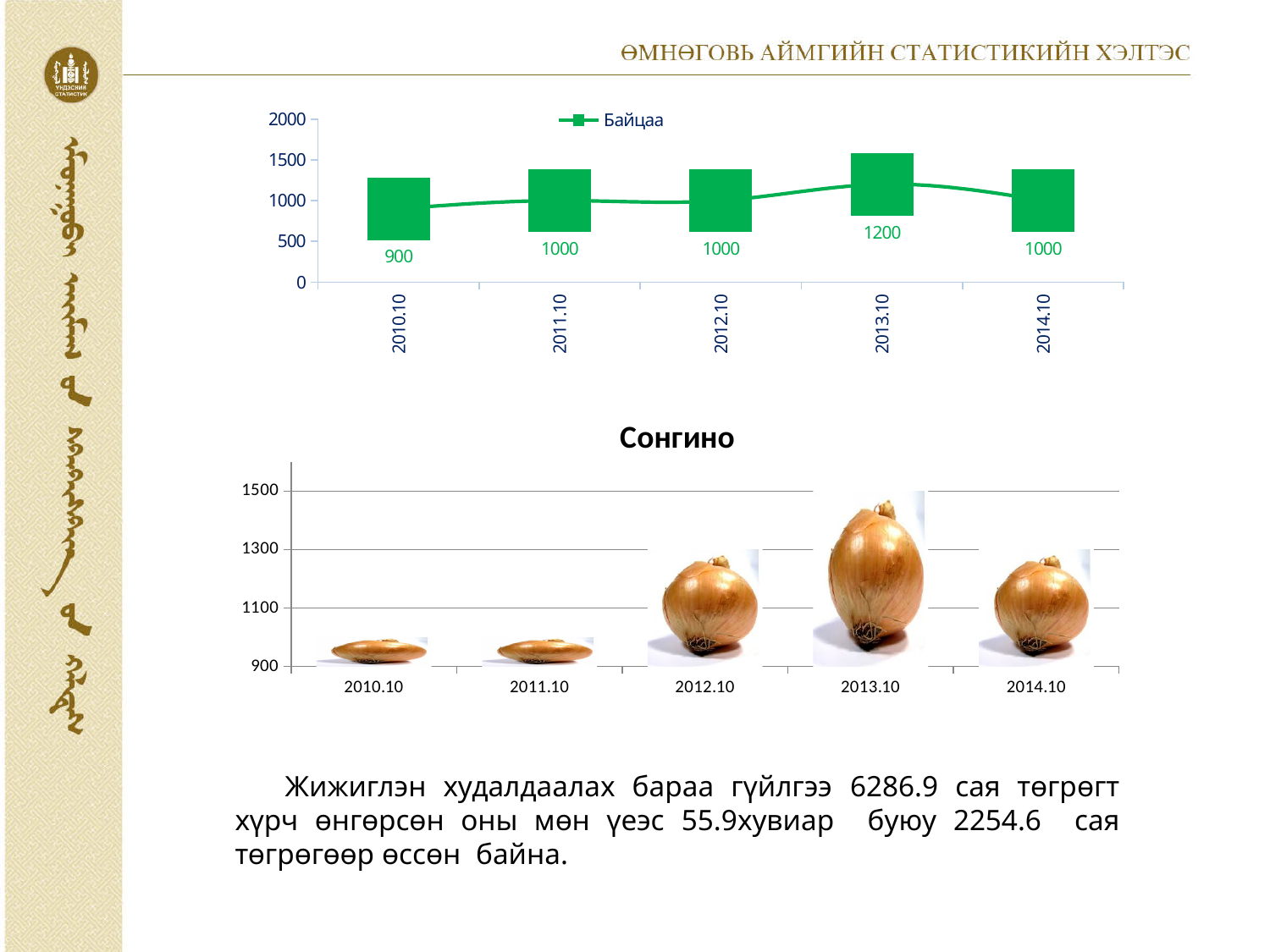
In the Байцаа chart at the top, what is the value for 2010.10? 900 In the Байцаа chart at the top, which period has the highest value? 2013.10 In the Байцаа chart at the top, how many series does the legend list? 1 In the Сонгино chart at the bottom, which period has the highest value? 2013.10 In the Байцаа chart at the top, what is the difference between the values for 2013.10 and 2010.10? 300 What kind of chart is the Байцаа chart at the top of the slide? Line chart In the Байцаа chart at the top, which is larger: the value for 2013.10 or the value for 2014.10? 2013.10 In the Байцаа chart at the top, what is the value for 2013.10? 1200 In the Сонгино chart at the bottom, is the value for 2013.10 greater or less than 1300? greater In the Сонгино chart at the bottom, is the value for 2010.10 greater or less than 1100? less In the Байцаа chart at the top, which period has the lowest value? 2010.10 In the Байцаа chart at the top, how many periods are plotted? 5